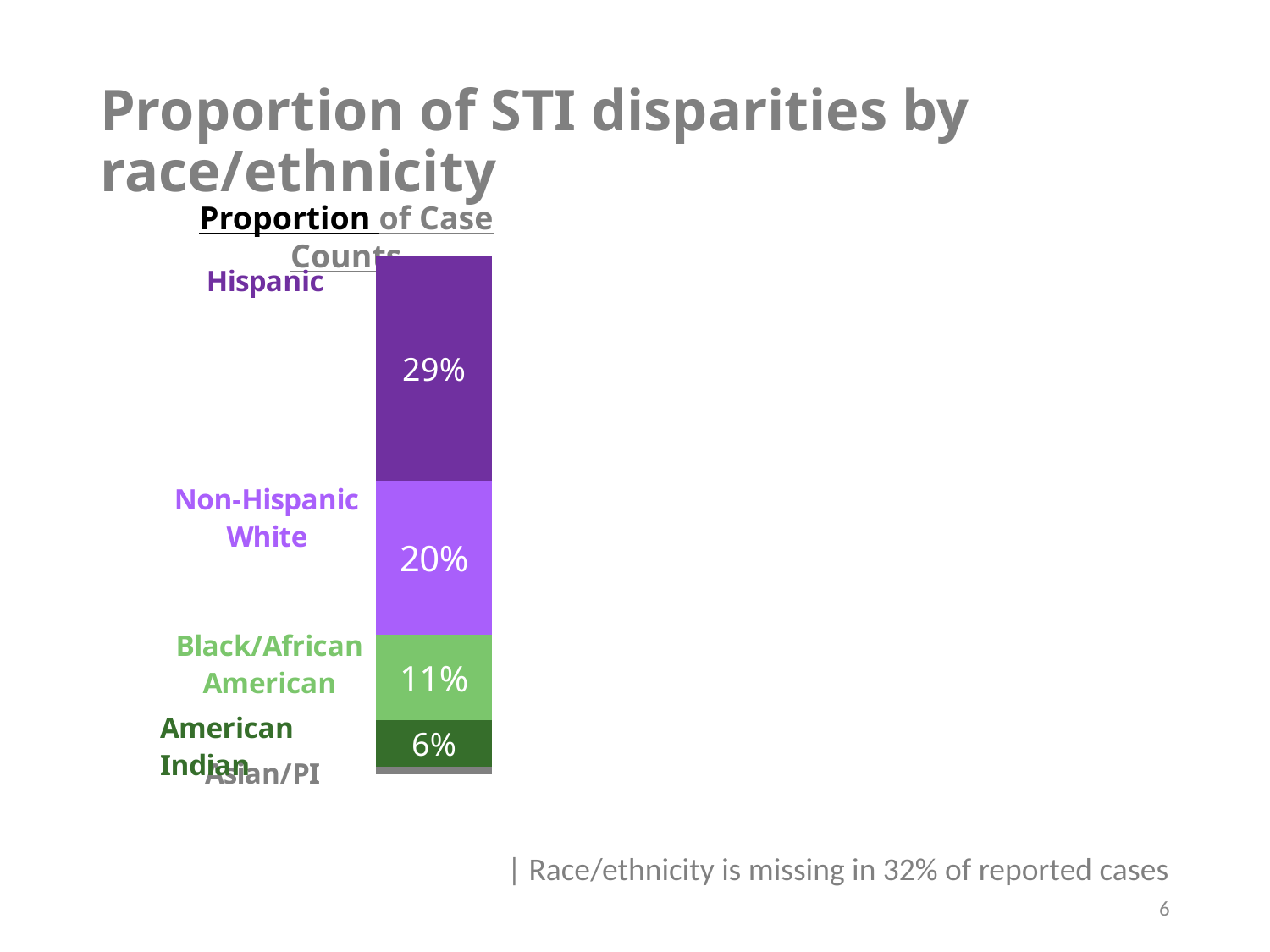
What percentage of case counts is shown for American Indian? 6% What is the title of the chart? Proportion of Case Counts What percentage of case counts is shown for Non-Hispanic White? 20% What kind of chart is shown on the slide? Stacked bar chart What is the difference in percentage points between the Black/African American and American Indian segments? 5 percentage points What percentage of case counts is shown for Black/African American? 11% Which is larger, the Non-Hispanic White segment or the Black/African American segment? Non-Hispanic White How many race/ethnicity segments are shown in the stacked bar? 5 Which race/ethnicity group has the smallest segment in the stacked bar? Asian/PI What percentage of case counts is shown for Hispanic? 29% What is the difference in percentage points between the Hispanic and Non-Hispanic White segments? 9 percentage points Which race/ethnicity group has the largest segment in the stacked bar? Hispanic